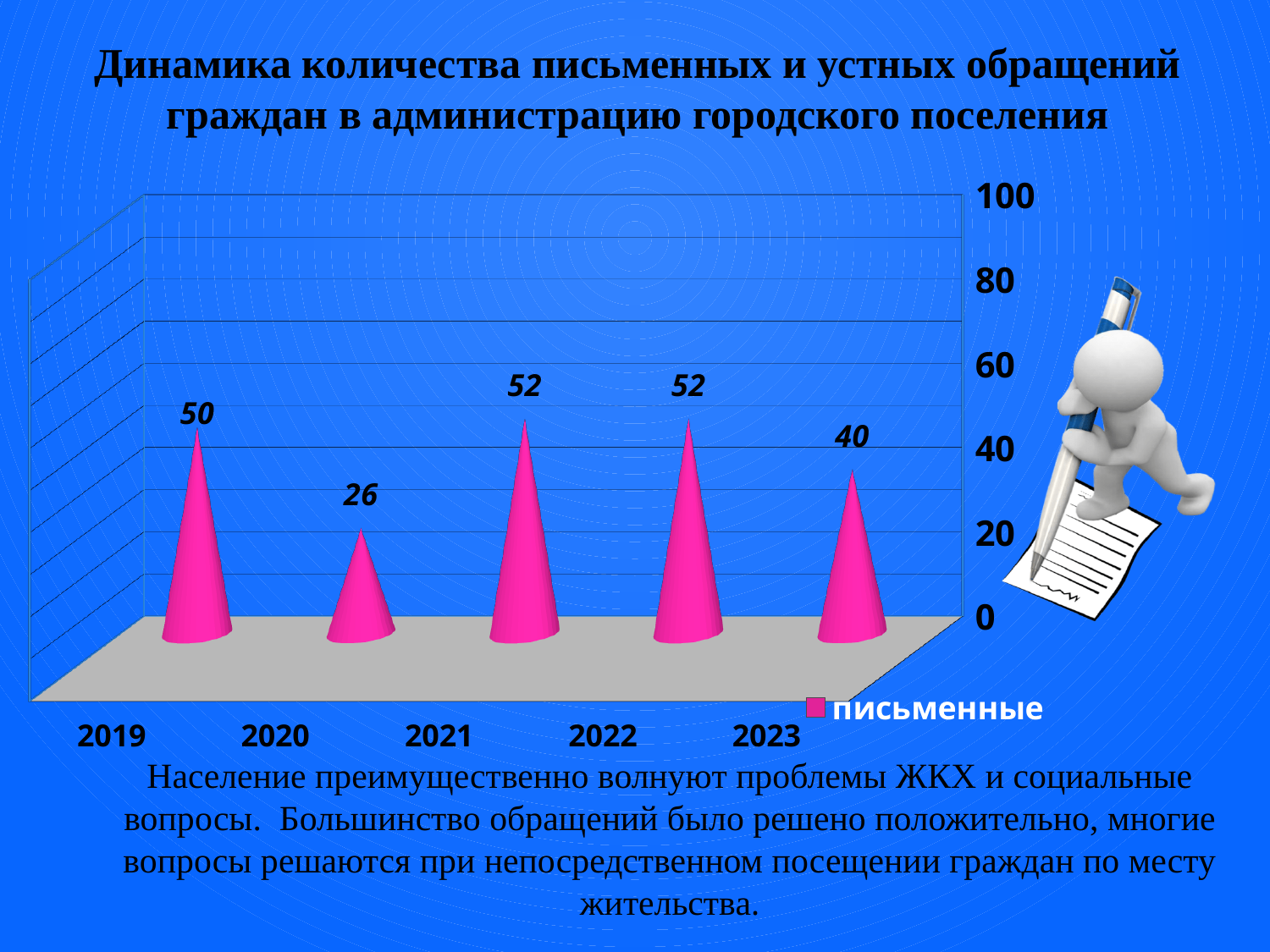
How many series does the legend list? 1 What is the name of the series shown in the legend? письменные What is the value for 2023? 40 Is the value for 2020 greater or less than 40? less What is the value for 2020? 26 What is the difference between the values for 2019 and 2023? 10 What is the difference between the values for 2021 and 2020? 26 How many years are shown on the x axis? 5 Which year has the lowest value? 2020 What is the value for 2019? 50 What kind of chart is shown on the slide? bar chart Which is larger, the value for 2019 or the value for 2023? 2019